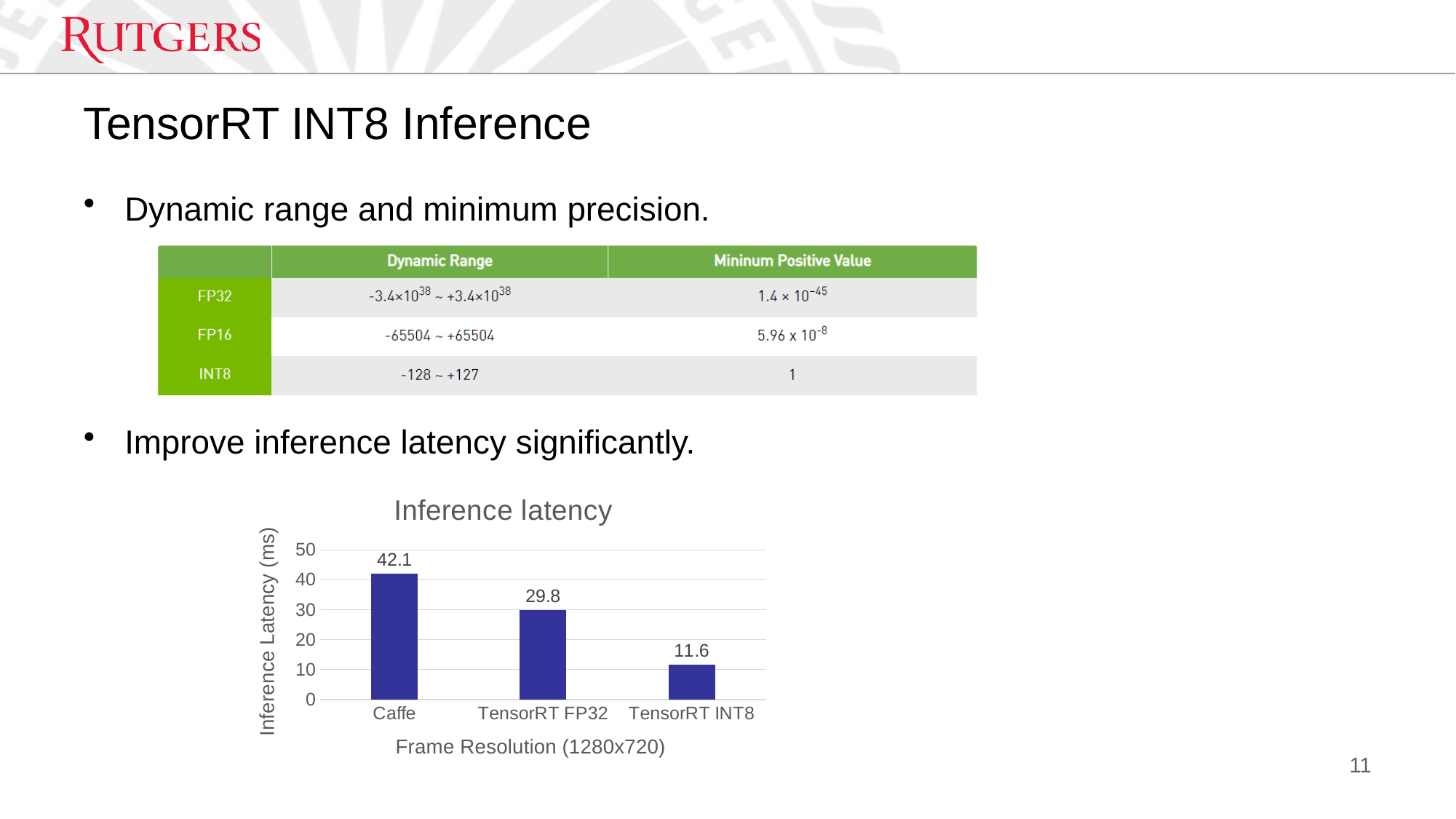
Which category has the lowest inference latency? TensorRT INT8 Which has a larger inference latency, TensorRT FP32 or TensorRT INT8? TensorRT FP32 How many categories are shown in the Inference latency chart? 3 What is the inference latency for TensorRT FP32? 29.8 What is the difference in inference latency between Caffe and TensorRT INT8? 30.5 What is the y-axis label of the Inference latency chart? Inference Latency (ms) Is the inference latency for Caffe greater or less than 40? greater What kind of chart is the Inference latency chart? bar chart What is the inference latency for TensorRT INT8? 11.6 Which category has the highest inference latency? Caffe What is the inference latency for Caffe? 42.1 What is the difference in inference latency between TensorRT FP32 and TensorRT INT8? 18.2